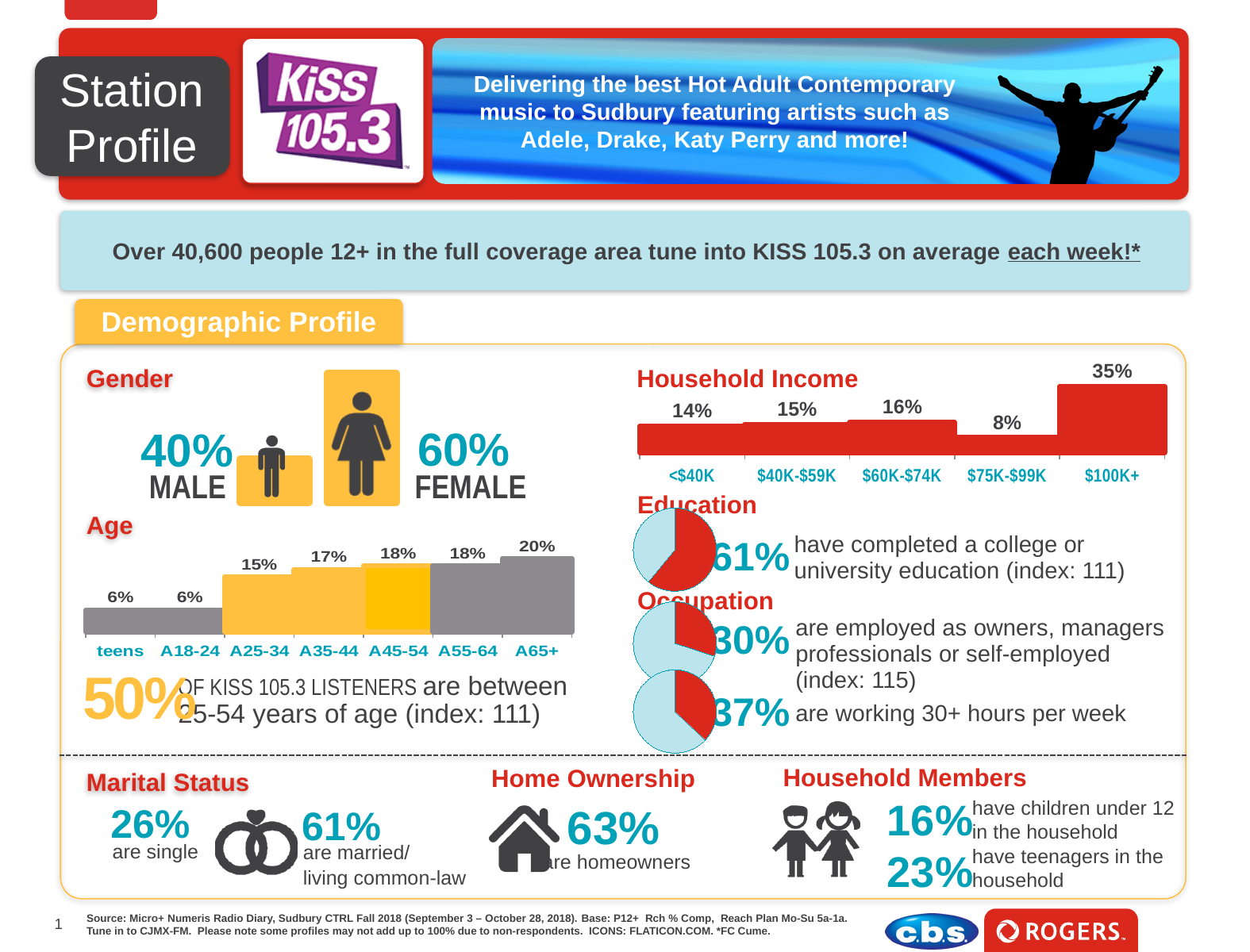
In the Household Income chart, which income category has the lowest value? $75K-$99K In the Household Income chart, what is the value for $100K+? 35% In the Age chart, which is larger, the value for A25-34 or the value for A45-54? A45-54 In the Age chart, which age group has the highest value? A65+ How many income categories are shown in the Household Income chart? 5 In the Age chart, what is the value for teens? 6% In the Household Income chart, which income category has the highest value? $100K+ What type of chart is the Age chart? Bar chart In the Household Income chart, what is the difference between the values for $100K+ and <$40K? 21% How many age groups are shown in the Age chart? 7 In the Age chart, what is the value for A35-44? 17% In the Household Income chart, what is the value for $75K-$99K? 8%